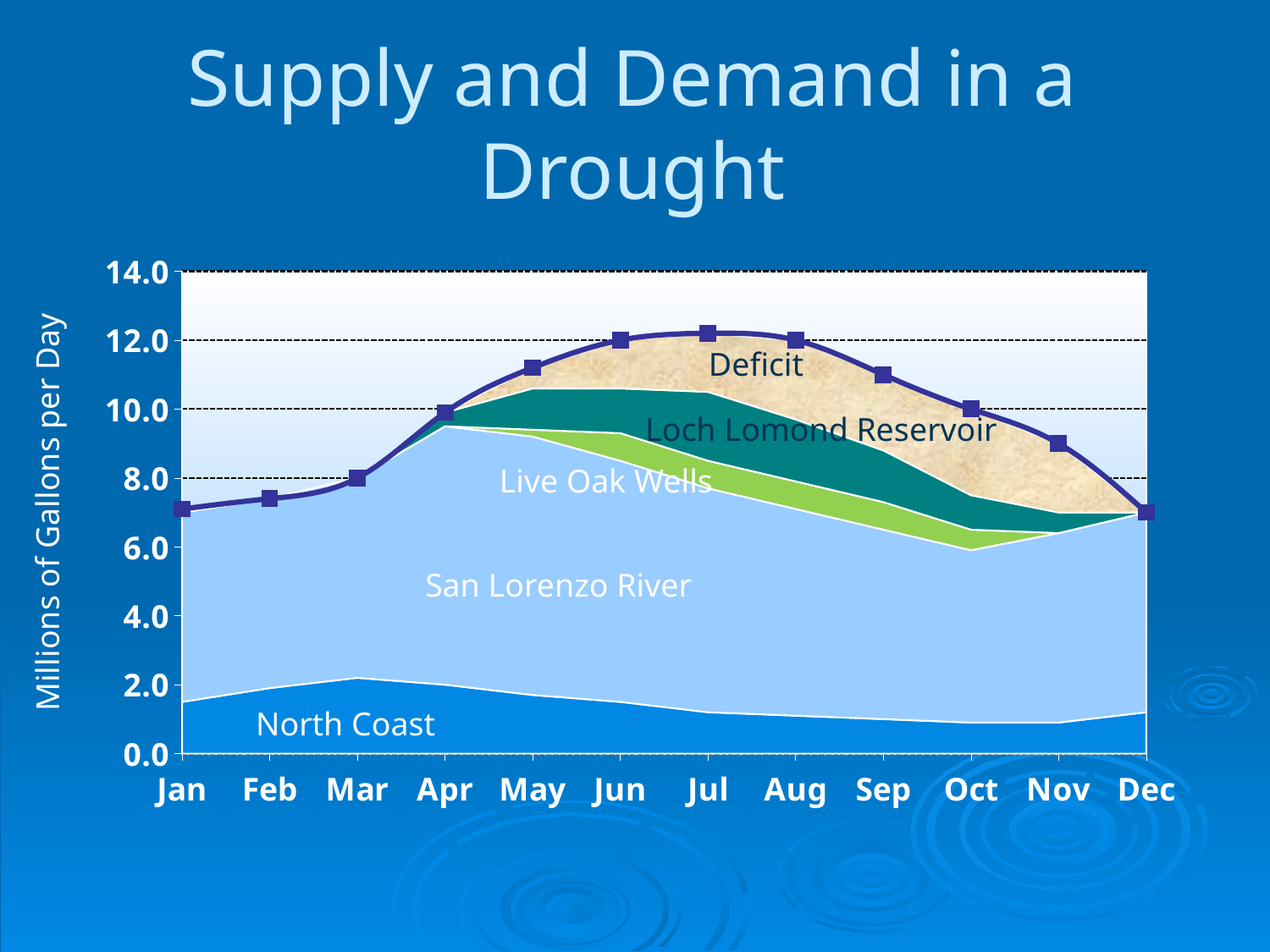
How many months are shown along the x axis? 12 Is the demand value for Jan greater or less than 8.0? less In which month does the demand line reach its highest value? Jul What is the demand value for Oct? 10.0 Does the demand line rise or fall from Jan to Jul? rise Which month has the higher demand value, Apr or Feb? Apr Which supply source is shown as the bottom area of the chart? North Coast Is the demand value for May greater or less than 10.0? greater What kind of chart is shown on the slide? area and line chart Is the demand value for Sep greater or less than 12.0? less What is the label on the y axis? Millions of Gallons per Day What is the demand value for Mar? 8.0